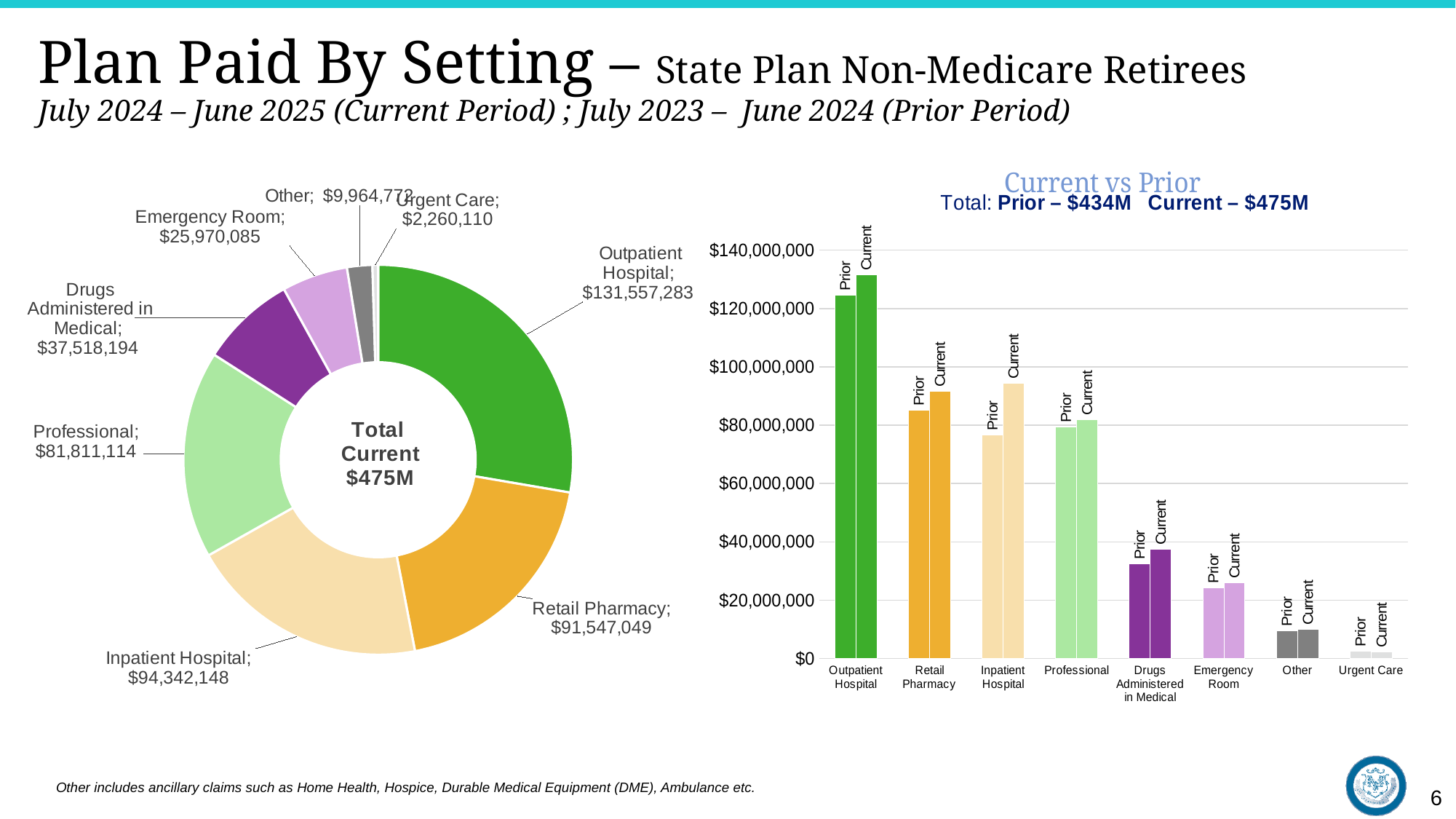
On the donut chart on the left, what is the value for Drugs Administered in Medical? $37,518,194 On the Current vs Prior chart, is the Current value for Outpatient Hospital greater or less than $120,000,000? greater On the donut chart on the left, which is larger: Emergency Room or Other? Emergency Room On the Current vs Prior chart, what total is given for the Prior period? $434M What kind of chart is the Current vs Prior chart on the right? Bar chart On the donut chart on the left, what is the value for Outpatient Hospital? $131,557,283 On the Current vs Prior chart, is the Prior value for Inpatient Hospital greater or less than $80,000,000? less On the donut chart on the left, how many settings are shown? 8 On the donut chart on the left, which setting has the smallest value? Urgent Care On the donut chart on the left, what is the difference between Inpatient Hospital and Retail Pharmacy? $2,795,099 On the donut chart on the left, which setting has the largest value? Outpatient Hospital On the donut chart on the left, what total is shown in the centre? Total Current $475M